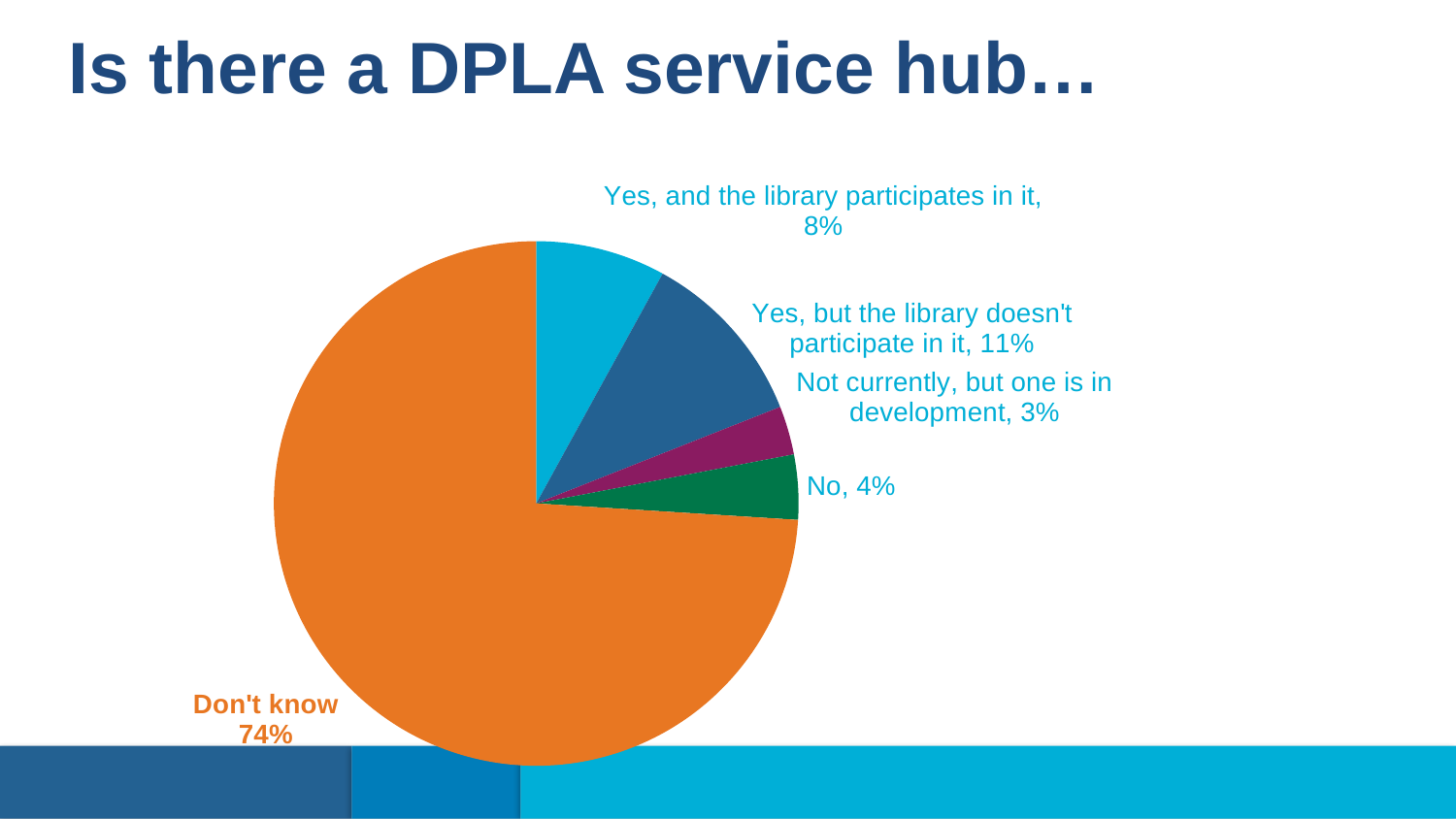
What percentage of respondents answered "No"? 4% What percentage of respondents answered "Yes, but the library doesn't participate in it"? 11% What percentage of respondents answered "Yes, and the library participates in it"? 8% Which is larger: the share for "No" or the share for "Not currently, but one is in development"? No What is the difference in percentage points between "Yes, but the library doesn't participate in it" and "Yes, and the library participates in it"? 3 What kind of chart is shown on the slide? pie chart What is the title of the slide containing the pie chart? Is there a DPLA service hub… What share of the pie is labelled "Don't know"? 74% How many slices does the pie chart have? 5 Which category has the largest slice of the pie? Don't know What percentage of respondents answered "Not currently, but one is in development"? 3% Which category has the smallest slice of the pie? Not currently, but one is in development